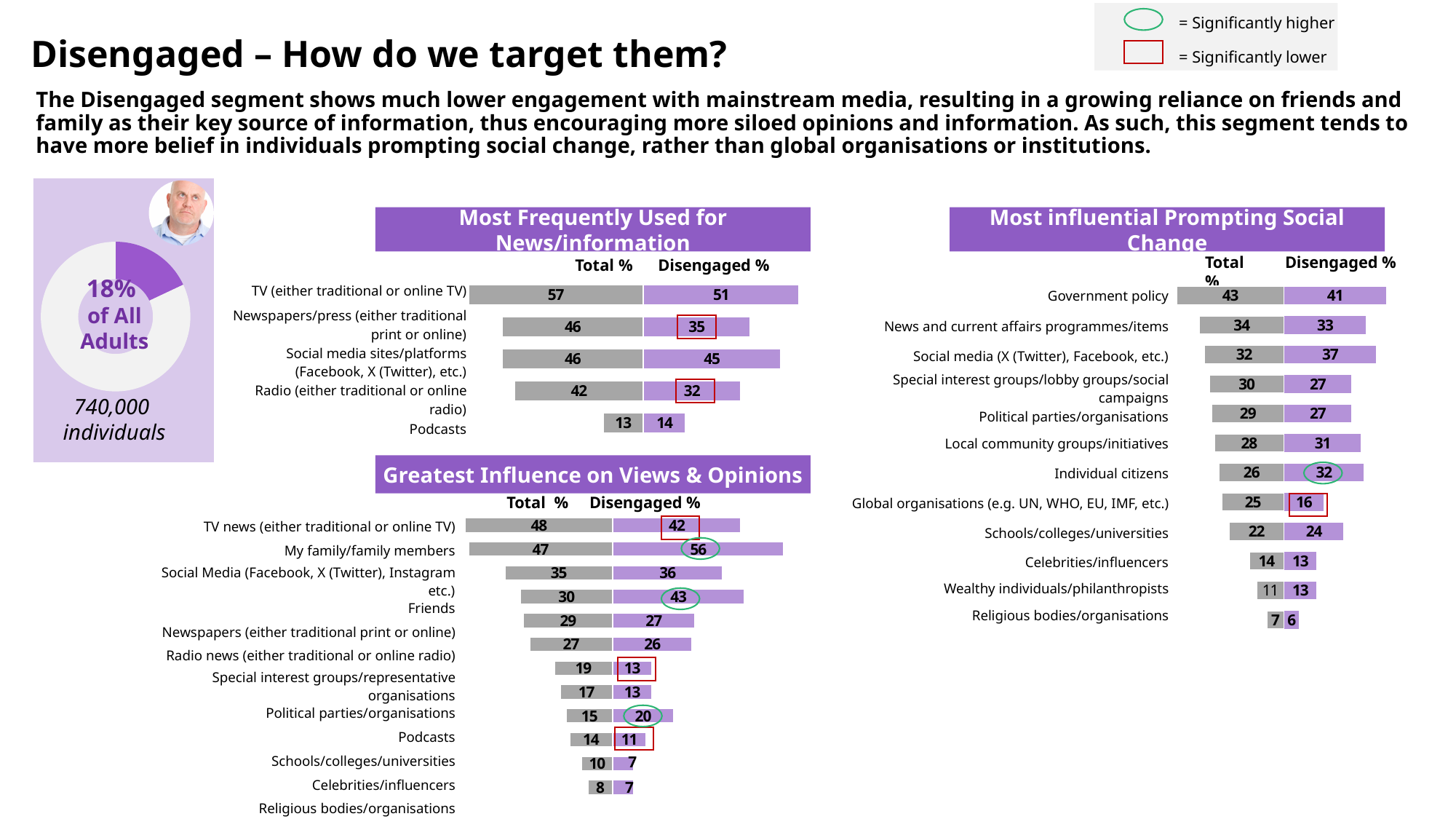
In the 'Greatest Influence on Views & Opinions' chart, what is the Disengaged % for My family/family members? 56 How many categories are shown in the 'Most Frequently Used for News/information' chart? 5 In the 'Most Frequently Used for News/information' chart, what is the difference between the Total % and Disengaged % for Newspapers/press? 11 In the 'Most Frequently Used for News/information' chart, what is the Total % for Radio (either traditional or online radio)? 42 In the 'Most Frequently Used for News/information' chart, what is the Disengaged % for TV (either traditional or online TV)? 51 In the 'Greatest Influence on Views & Opinions' chart, is the Disengaged % for TV news larger or smaller than the Disengaged % for My family/family members? smaller In the 'Most influential Prompting Social Change' chart, what is the difference between the Disengaged % and Total % for Individual citizens? 6 In the 'Most influential Prompting Social Change' chart, what is the Disengaged % for Global organisations (e.g. UN, WHO, EU, IMF, etc.)? 16 In the 'Greatest Influence on Views & Opinions' chart, which category has the highest Total %? TV news (either traditional or online TV) In the 'Most Frequently Used for News/information' chart, which category has the lowest Total %? Podcasts In the 'Most influential Prompting Social Change' chart, which category has the highest Total %? Government policy How many categories are listed in the 'Most influential Prompting Social Change' chart? 12